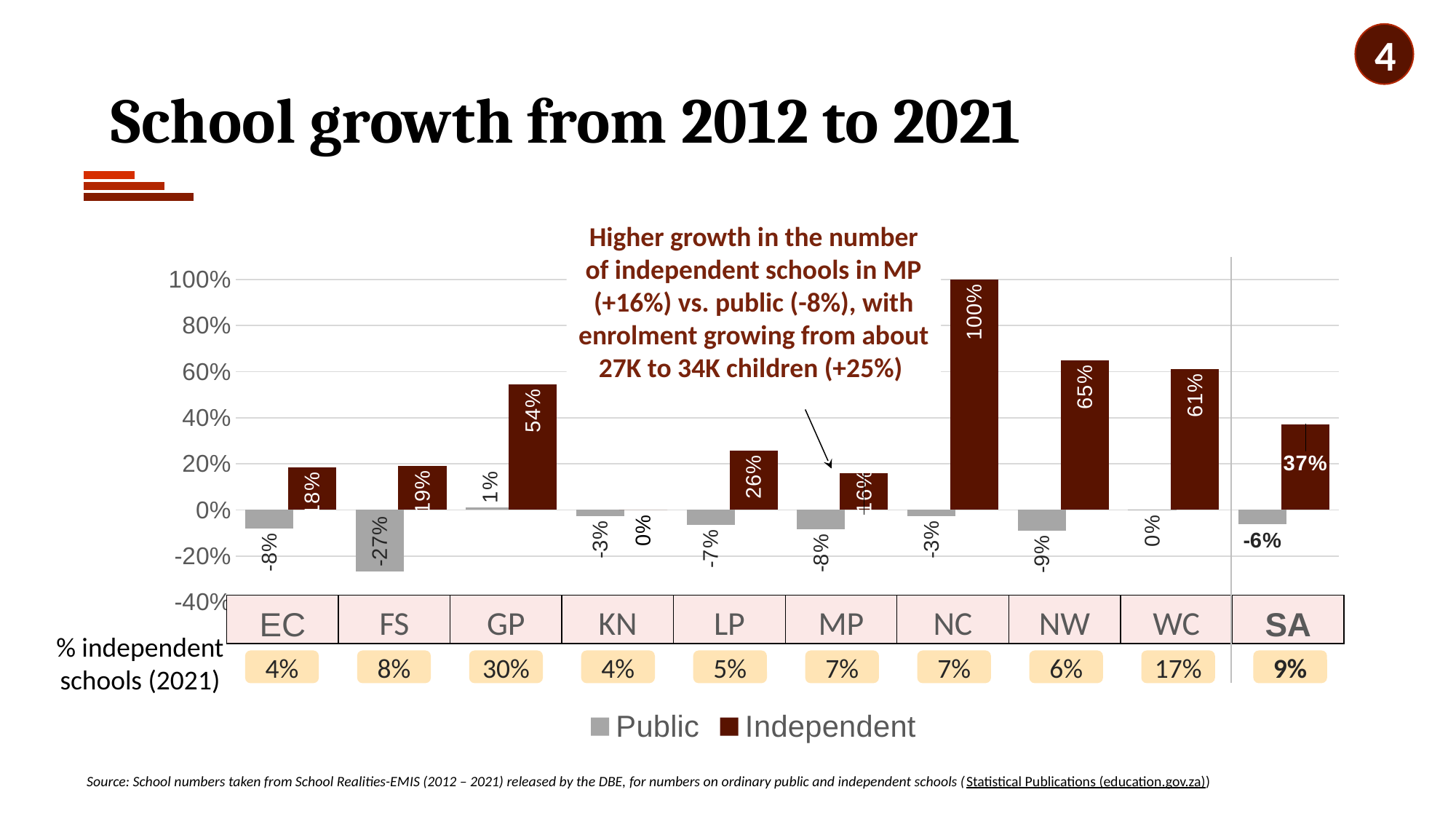
What is the Independent school growth value for NC? 100% Which category has the highest Independent value? NC How many categories are shown along the x axis? 10 What is the difference between the Independent values for NW and WC? 4 percentage points What are the two series named in the legend? Public and Independent What is the Public value for WC? 0% Which is larger, the Independent value for GP or for LP? GP What is the Public school growth value for FS? -27% Which category has the lowest Public value? FS How many series does the legend list? 2 What is the Independent value for SA? 37% What kind of chart is shown on the slide? bar chart